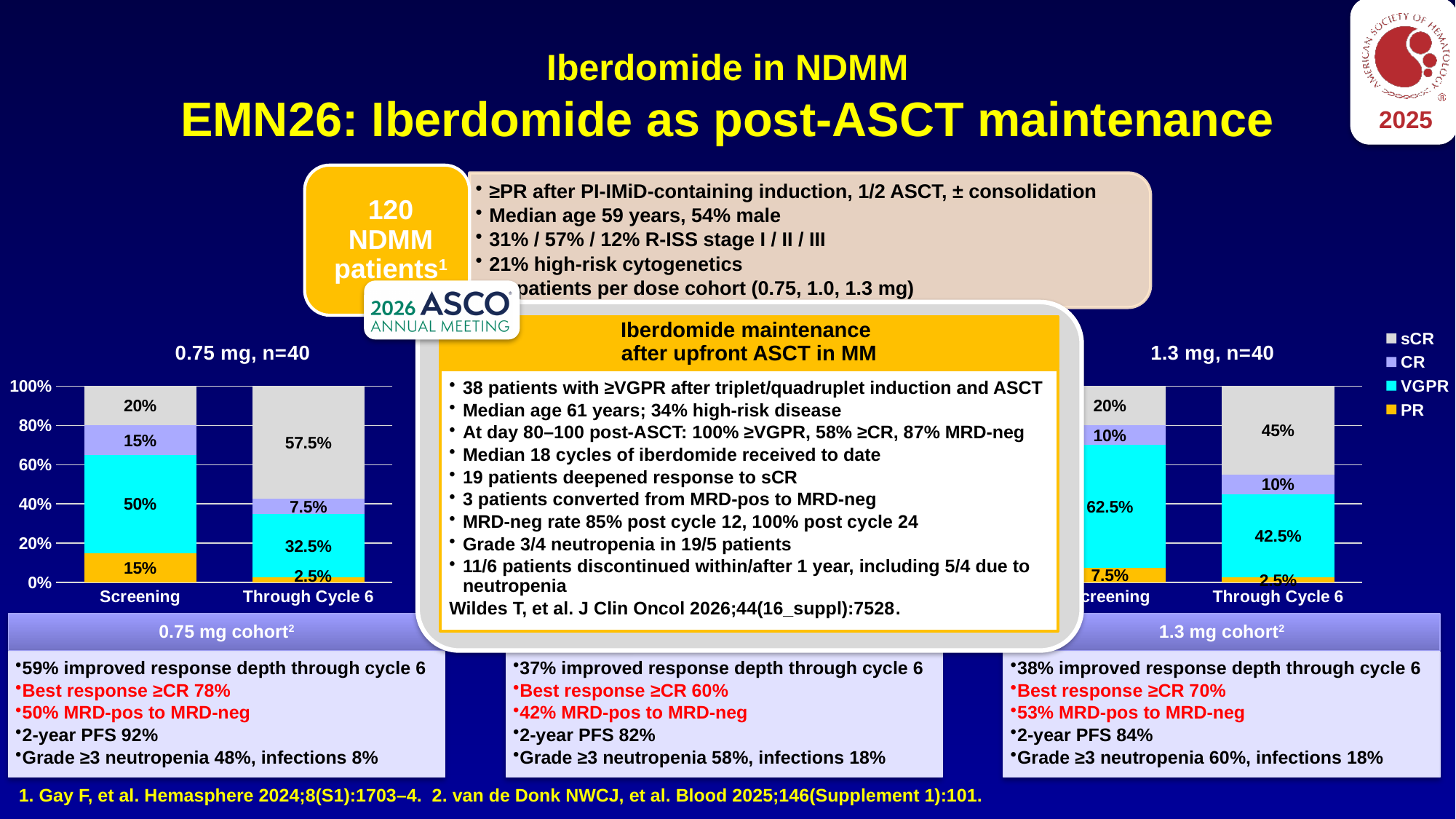
What kind of chart is the 0.75 mg, n=40 chart? Stacked bar chart In the 0.75 mg, n=40 chart, by how many percentage points did the sCR share increase from Screening to Through Cycle 6? 37.5 In the 0.75 mg, n=40 chart, what is the total of the Screening bar? 100% In the 0.75 mg, n=40 chart, what percentage of patients had sCR through cycle 6? 57.5% In the 1.3 mg, n=40 chart, what percentage of patients had sCR through cycle 6? 45% In the 1.3 mg, n=40 chart, what percentage of patients had VGPR at screening? 62.5% In the 0.75 mg, n=40 chart, which response category is the smallest segment of the Through Cycle 6 bar? PR How many series does the legend list for the response charts? 4 In the 0.75 mg, n=40 chart, which response category is the largest segment of the Through Cycle 6 bar? sCR In the 1.3 mg, n=40 chart, by how many percentage points did the VGPR share decrease from Screening to Through Cycle 6? 20 In the 0.75 mg, n=40 chart, what percentage of patients had VGPR at screening? 50% Is the sCR share through cycle 6 larger in the 0.75 mg, n=40 chart or the 1.3 mg, n=40 chart? 0.75 mg, n=40